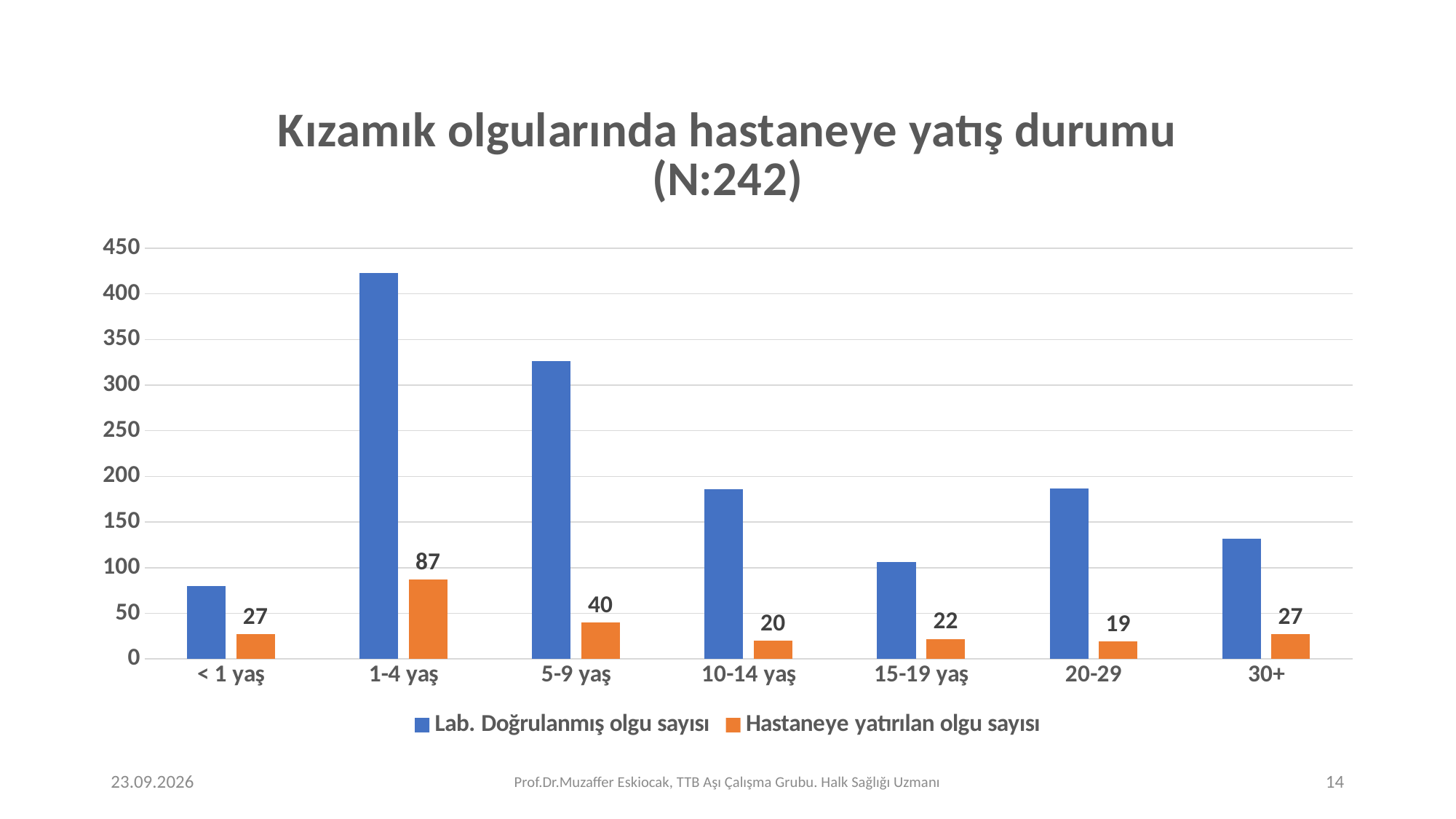
What is the value for 'Hastaneye yatırılan olgu sayısı' in the 30+ category? 27 What is the value for 'Hastaneye yatırılan olgu sayısı' in the 1-4 yaş category? 87 How many series does the legend list? 2 Is the value for 'Lab. Doğrulanmış olgu sayısı' in the < 1 yaş category greater or less than 100? less What is the value for 'Hastaneye yatırılan olgu sayısı' in the 5-9 yaş category? 40 Which age group has the highest value for 'Lab. Doğrulanmış olgu sayısı'? 1-4 yaş Is the value for 'Lab. Doğrulanmış olgu sayısı' in the 1-4 yaş category greater or less than 400? greater How many age group categories are shown on the x axis? 7 What is the difference between the 'Hastaneye yatırılan olgu sayısı' values for 1-4 yaş and 5-9 yaş? 47 Which is larger, the 'Hastaneye yatırılan olgu sayısı' value for 10-14 yaş or for 15-19 yaş? 15-19 yaş Which age group has the lowest value for 'Hastaneye yatırılan olgu sayısı'? 20-29 Which age group has the highest value for 'Hastaneye yatırılan olgu sayısı'? 1-4 yaş